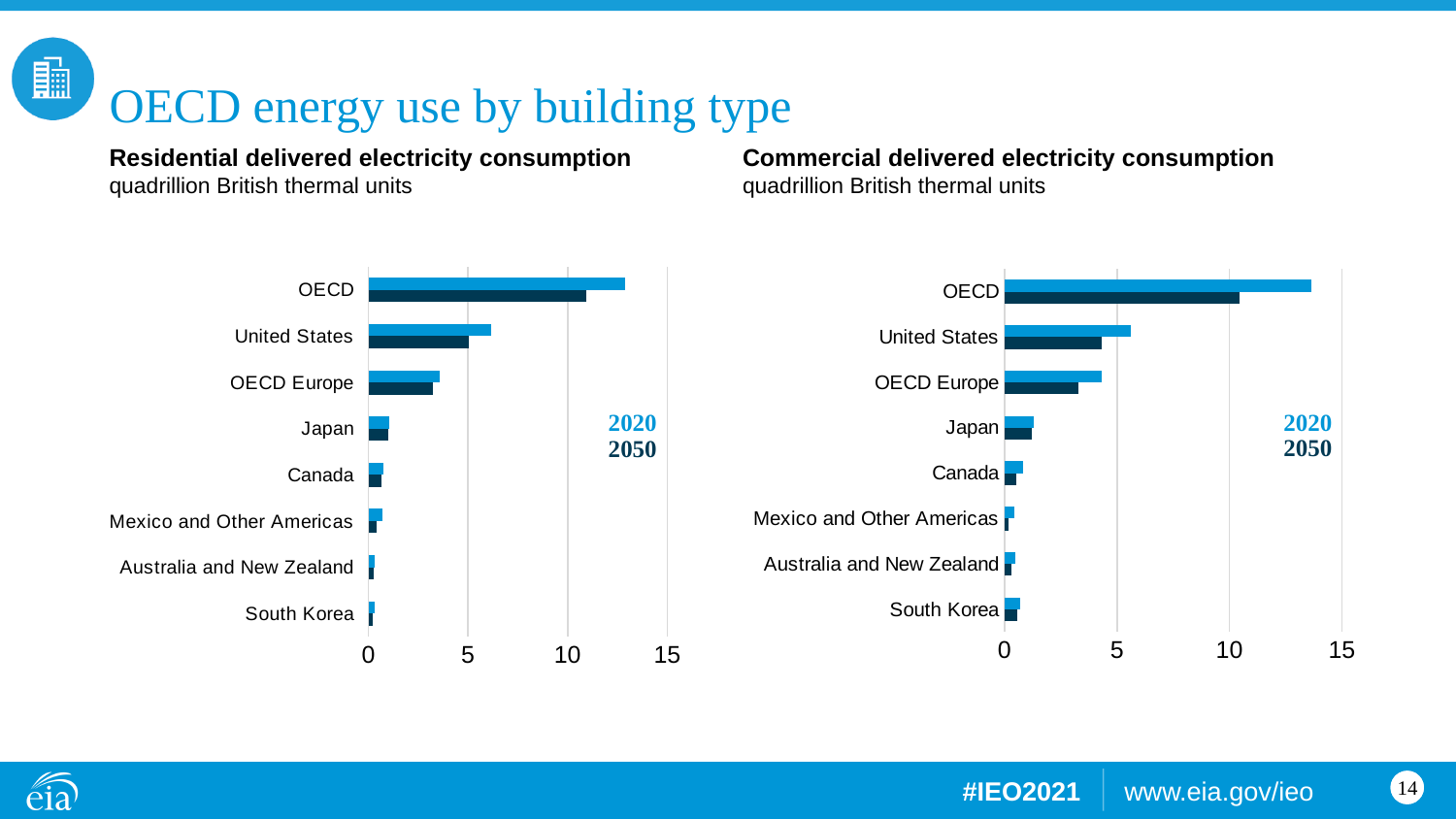
On the Commercial delivered electricity consumption chart, which category has the lowest 2020 value? Mexico and Other Americas How many series does the legend of the Residential delivered electricity consumption chart list? 2 How many categories are shown on the Commercial delivered electricity consumption chart? 8 What unit is given under the title of the Commercial delivered electricity consumption chart? quadrillion British thermal units What kind of chart is the Residential delivered electricity consumption chart? bar chart On the Residential delivered electricity consumption chart, is the 2020 value for United States greater or less than 5? greater On the Residential delivered electricity consumption chart, which category has the highest 2020 value? OECD On the Commercial delivered electricity consumption chart, is the 2050 value for United States greater or less than 5? less What are the two legend entries on the Residential delivered electricity consumption chart? 2020 and 2050 On the Residential delivered electricity consumption chart, is the 2020 value for OECD greater or less than 10? greater On the Residential delivered electricity consumption chart, which is larger: the 2020 value for OECD Europe or the 2020 value for Japan? OECD Europe On the Commercial delivered electricity consumption chart, which is larger for OECD: the 2020 value or the 2050 value? 2020